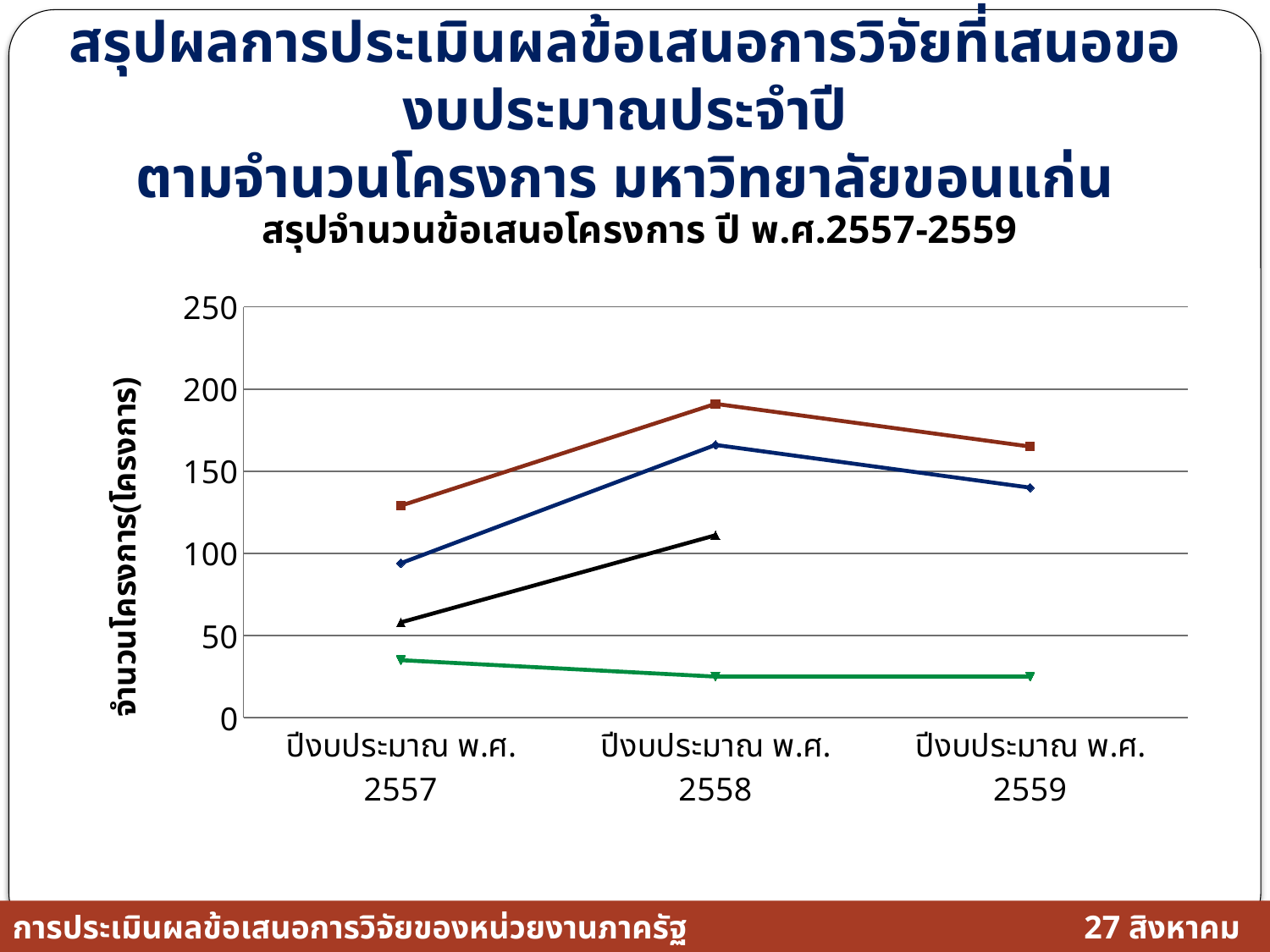
What is the label on the vertical axis? จำนวนโครงการ(โครงการ) Is the value of the brown (square-marker) line for ปีงบประมาณ พ.ศ. 2558 greater or less than 150? greater Which line has the lowest value in ปีงบประมาณ พ.ศ. 2559? green line Is the value of the brown (square-marker) line for ปีงบประมาณ พ.ศ. 2559 greater or less than 150? greater Does the blue (diamond-marker) line rise or fall from ปีงบประมาณ พ.ศ. 2557 to ปีงบประมาณ พ.ศ. 2558? rise What is the title of the chart? สรุปจำนวนข้อเสนอโครงการ ปี พ.ศ.2557-2559 What kind of chart is shown on the slide? line chart For ปีงบประมาณ พ.ศ. 2558, which line has the larger value, the brown line or the blue line? brown line How many fiscal-year categories are shown on the x axis? 3 Is the value of the blue (diamond-marker) line for ปีงบประมาณ พ.ศ. 2557 greater or less than 100? less In which fiscal year does the brown (square-marker) line reach its highest value? ปีงบประมาณ พ.ศ. 2558